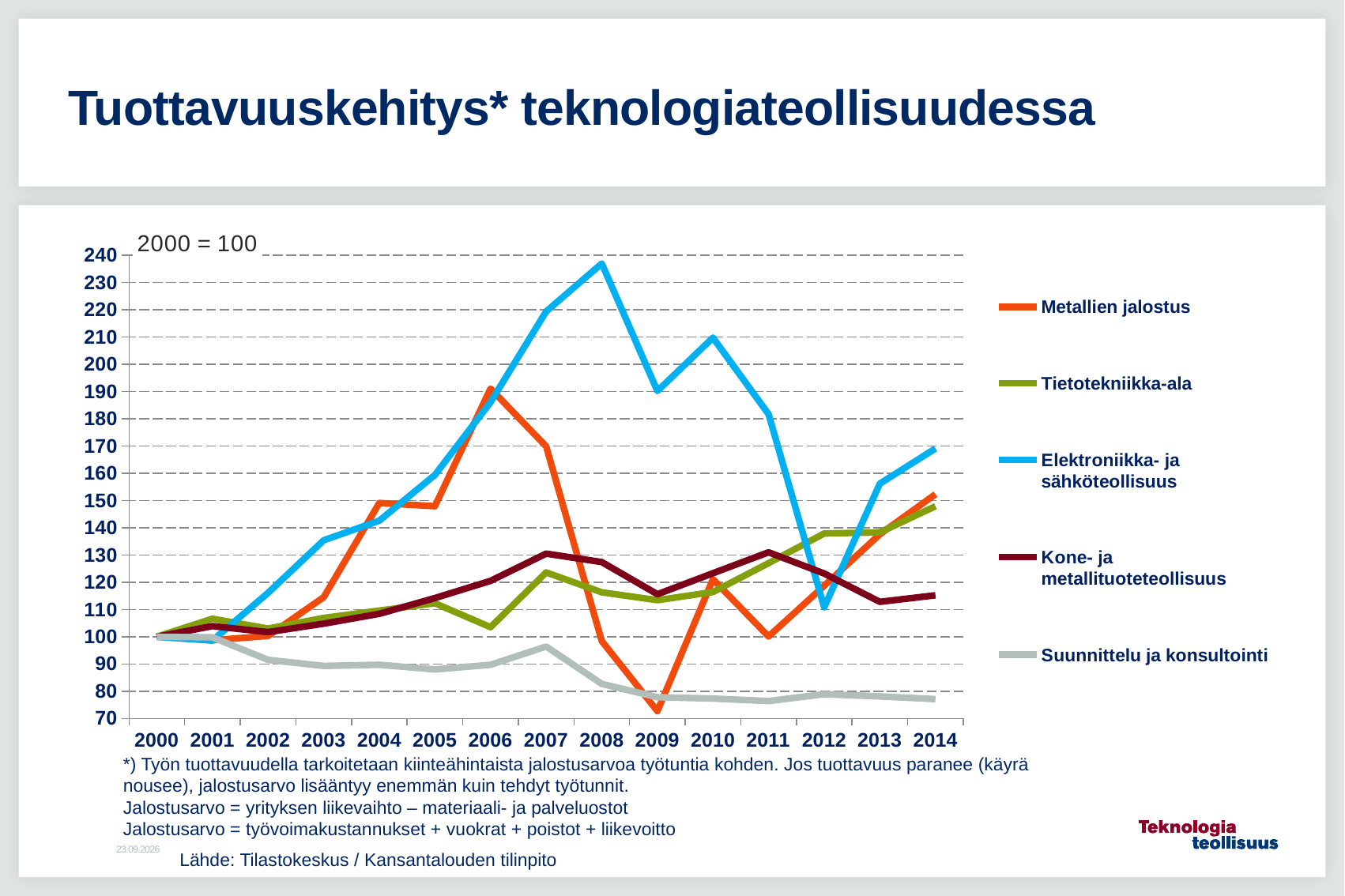
Is the value for Metallien jalostus in 2009 greater or less than 80? less Is the value for Elektroniikka- ja sähköteollisuus in 2008 greater or less than 230? greater Which series has the lowest value in 2014? Suunnittelu ja konsultointi What base year note is printed at the top of the chart? 2000 = 100 Which series reaches the highest value on the chart? Elektroniikka- ja sähköteollisuus In 2012, which is larger: Tietotekniikka-ala or Elektroniikka- ja sähköteollisuus? Tietotekniikka-ala How many years are shown on the x axis? 15 In which year does the Elektroniikka- ja sähköteollisuus line reach its peak? 2008 Does the Suunnittelu ja konsultointi line rise or fall from 2000 to 2014? fall How many series does the legend list? 5 Is the value for Kone- ja metallituoteteollisuus in 2007 greater or less than 120? greater What kind of chart is shown on the slide? line chart